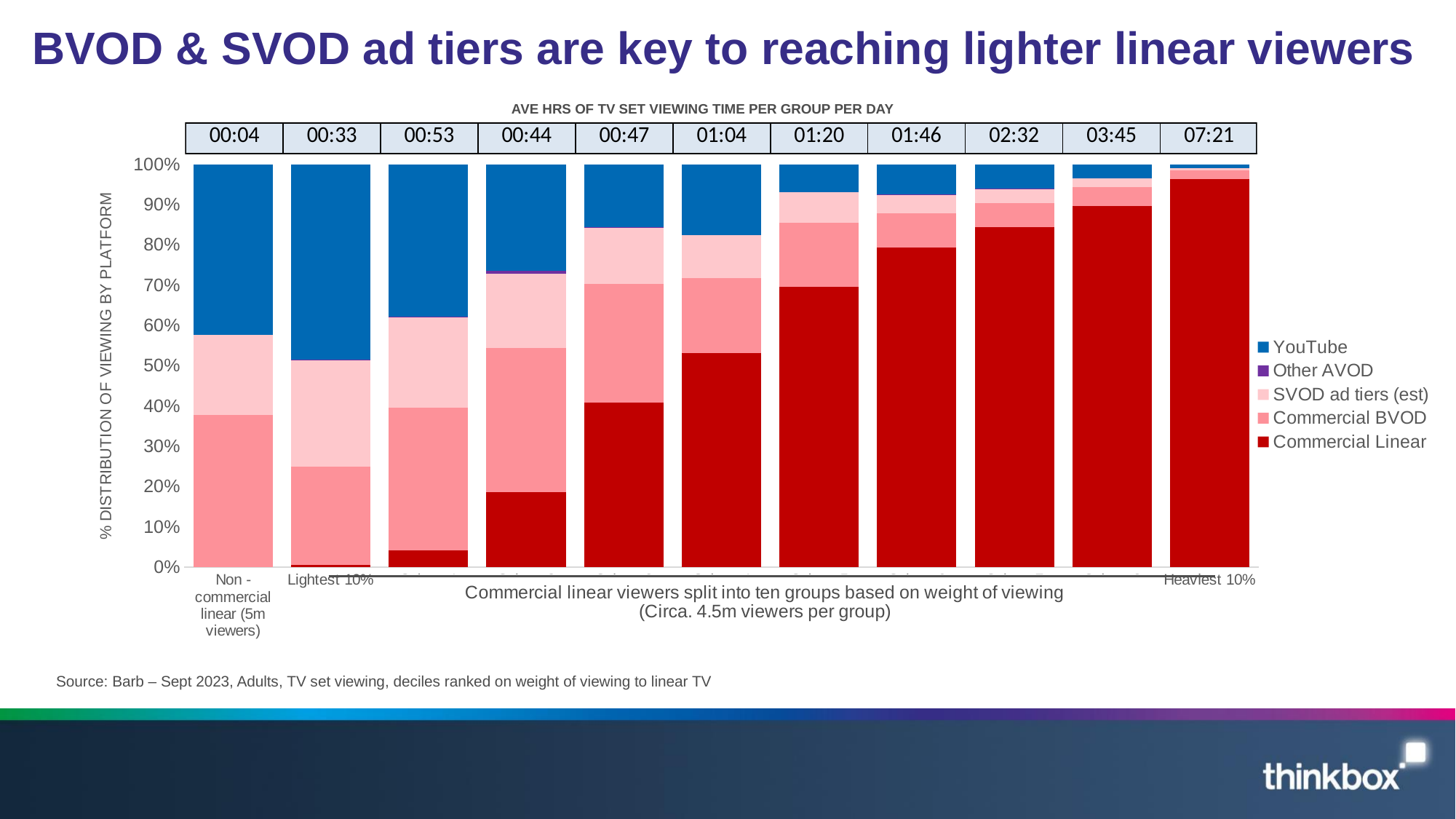
What is the average hours of TV set viewing time per day shown for the Heaviest 10% group? 07:21 How many series does the legend list? 5 What is the average hours of TV set viewing time per day shown for the Lightest 10% group? 00:33 Which group has the highest average hours of TV set viewing time per day? Heaviest 10% How many bars (viewer groups) are plotted in the chart? 11 What is the average hours of TV set viewing time per day shown for the Non-commercial linear (5m viewers) group? 00:04 What kind of chart is shown on the slide? Stacked bar chart Is the Commercial Linear share for the Heaviest 10% group greater or less than 90%? greater Which series is shown in dark red in the legend? Commercial Linear Does the Commercial Linear share rise or fall moving from the Lightest 10% group to the Heaviest 10% group? rises Which group has the lowest average hours of TV set viewing time per day? Non-commercial linear (5m viewers) Is the Commercial Linear share for the Lightest 10% group greater or less than 10%? less